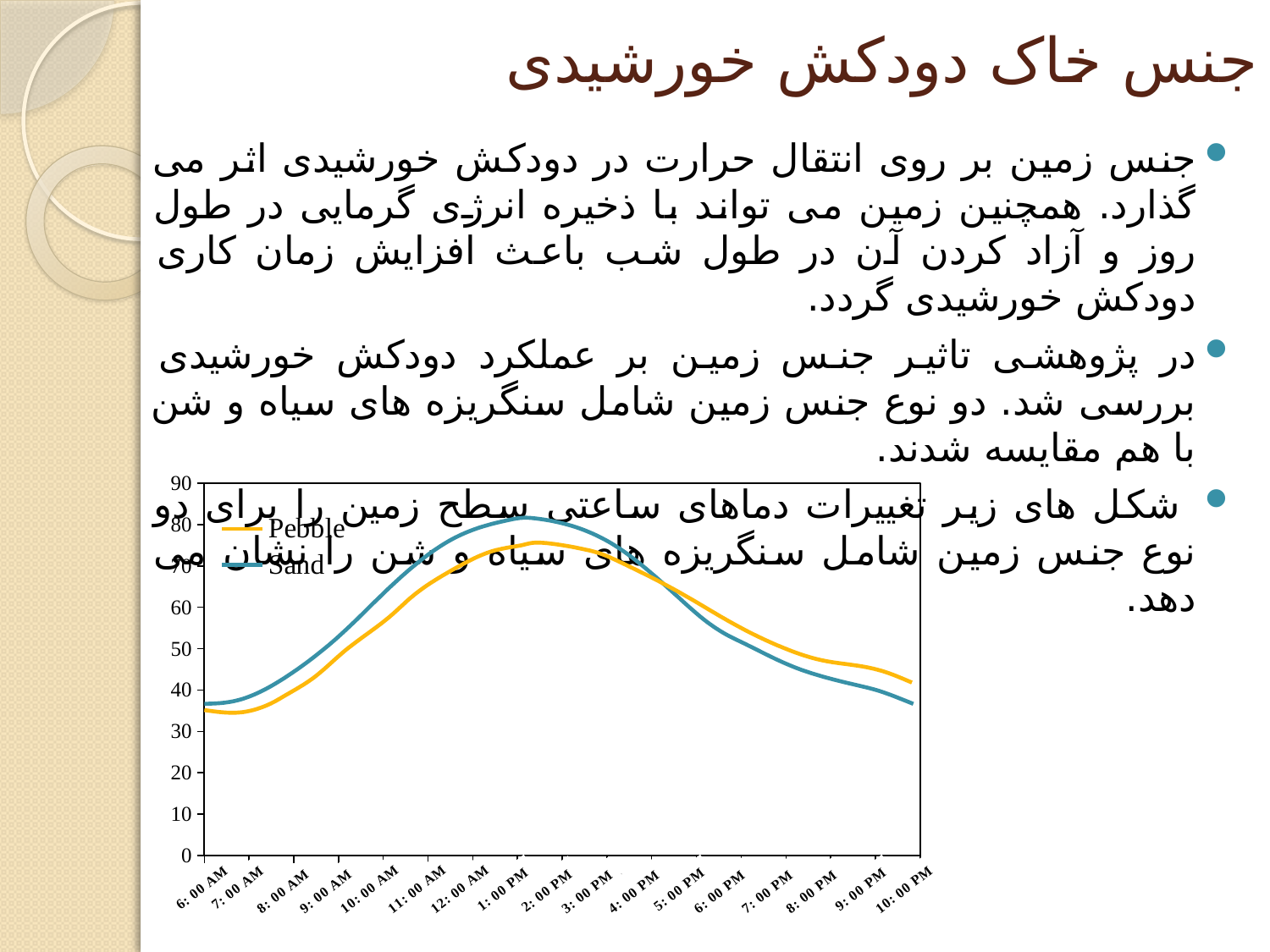
What kind of chart is shown on the slide? line chart How many series does the chart legend list? 2 Does the Sand line rise or fall from 6:00 AM to 1:00 PM? rise At 8:00 PM, which series has the higher value, Pebble or Sand? Pebble Is the value of the Sand line at 1:00 PM greater or less than 70? greater Which colour is used for the Sand line in the chart? teal (blue-green) How many time labels are shown along the x axis of the chart? 17 What are the two series named in the chart legend? Pebble and Sand Is the value of the Pebble line at 10:00 PM greater or less than 50? less Is the value of the Pebble line at 2:00 PM greater or less than 70? greater At 10:00 AM, which series has the higher value, Pebble or Sand? Sand